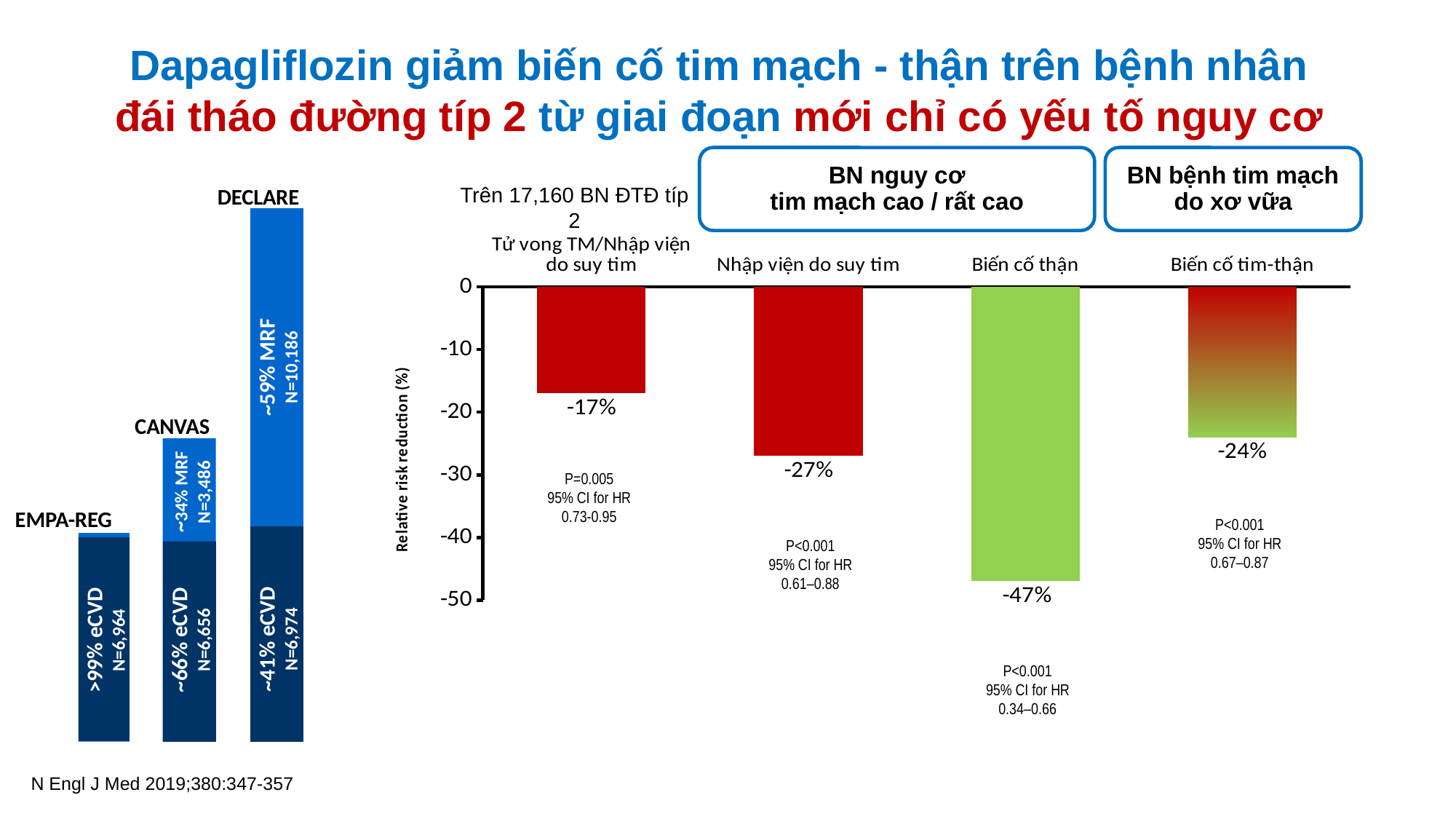
On the right-hand chart (Relative risk reduction), what is the value for Biến cố tim-thận? -24% On the right-hand chart (Relative risk reduction), which category shows the smallest relative risk reduction? Tử vong TM/Nhập viện do suy tim On the left-hand chart, which trial has the tallest bar? DECLARE On the right-hand chart (Relative risk reduction), which category shows the largest relative risk reduction? Biến cố thận On the left-hand chart, what percentage of the DECLARE population is labelled MRF? ~59% MRF What kind of chart is the right-hand chart (Relative risk reduction)? Bar chart On the right-hand chart (Relative risk reduction), what is the value for Biến cố thận? -47% On the right-hand chart (Relative risk reduction), how many bars are plotted? 4 On the left-hand chart, what is the N value for the eCVD segment of CANVAS? N=6,656 On the right-hand chart (Relative risk reduction), what is the value for Nhập viện do suy tim? -27% On the right-hand chart (Relative risk reduction), what is the difference between the values for Biến cố thận and Nhập viện do suy tim? 20 percentage points On the right-hand chart (Relative risk reduction), what is the value for Tử vong TM/Nhập viện do suy tim? -17%